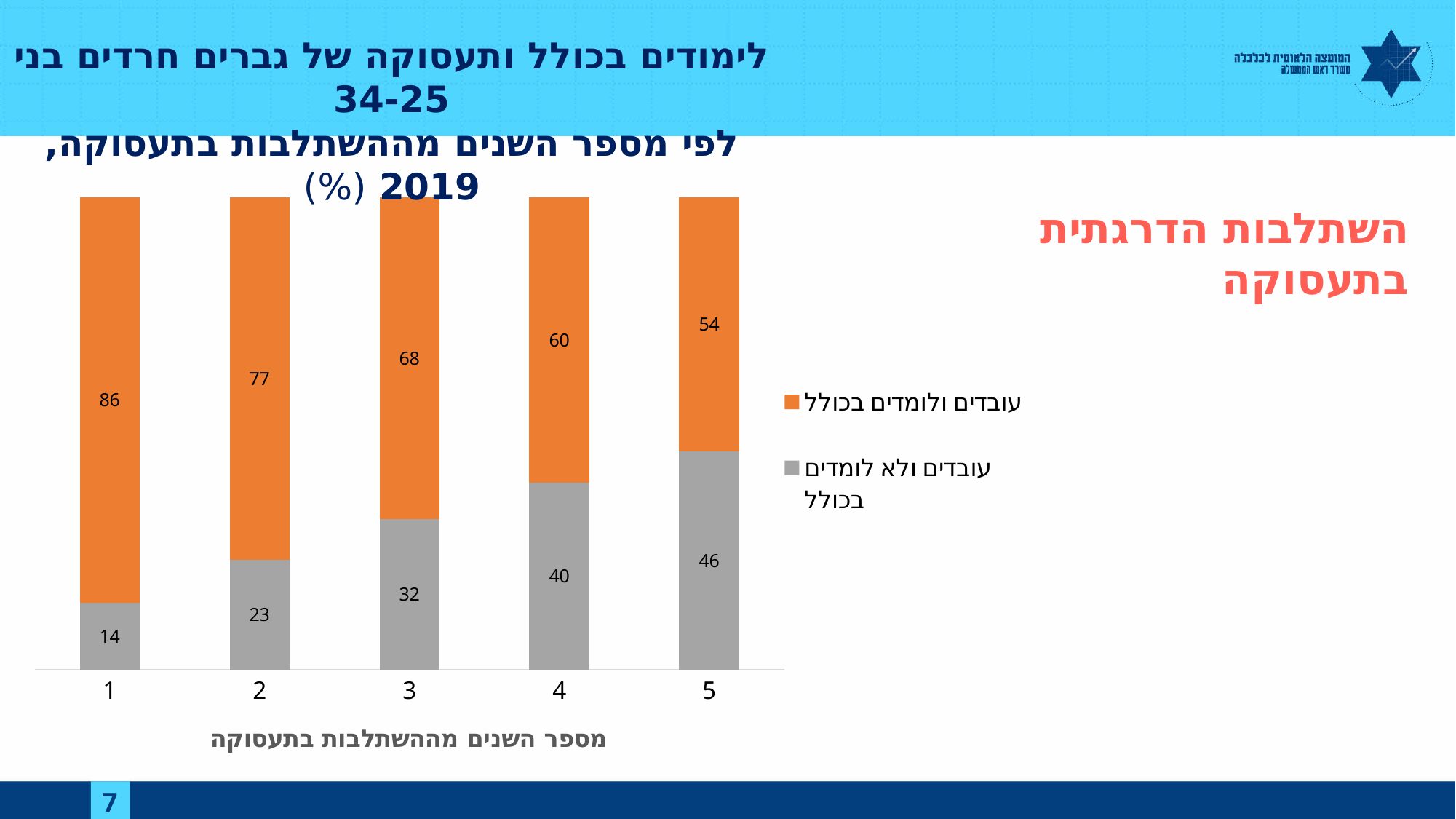
How many series does the legend list? 2 Which category has the highest value for "עובדים ולא לומדים בכולל"? 5 How many categories are shown on the x axis? 5 What is the difference between the "עובדים ולומדים בכולל" values at category 1 and category 2? 9 Do the values for "עובדים ולא לומדים בכולל" rise or fall from category 1 to category 5? rise Which category has the lowest value for "עובדים ולומדים בכולל"? 5 What is the value for "עובדים ולומדים בכולל" at category 5? 54 What is the value for "עובדים ולא לומדים בכולל" at category 4? 40 What is the value for "עובדים ולא לומדים בכולל" at category 3? 32 What is the value for "עובדים ולומדים בכולל" at category 1? 86 What kind of chart is shown on the slide? stacked bar chart Which is larger at category 4: "עובדים ולומדים בכולל" or "עובדים ולא לומדים בכולל"? עובדים ולומדים בכולל